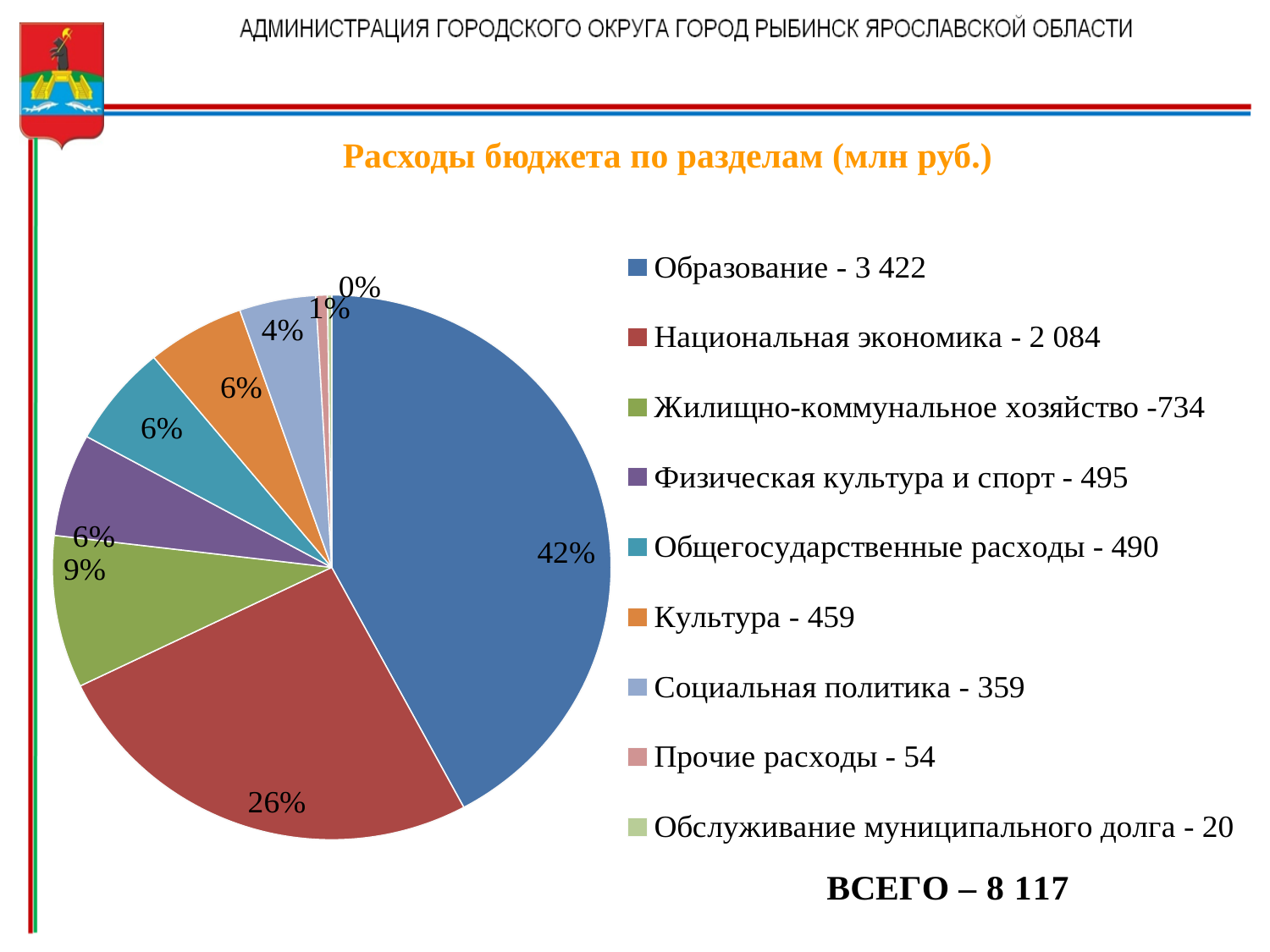
Which category has the largest value? Образование What is the total (ВСЕГО) shown on the slide? 8 117 What is the title of the chart? Расходы бюджета по разделам (млн руб.) What share of the pie does Образование take? 42% What is the value for Социальная политика according to the legend? 359 Which is larger: the value for Физическая культура и спорт or for Общегосударственные расходы? Физическая культура и спорт What is the value for Культура according to the legend? 459 What kind of chart is shown on the slide? pie chart What is the difference between the values for Образование and Национальная экономика? 1 338 Which category has the smallest value? Обслуживание муниципального долга What share of the pie does Национальная экономика take? 26% How many categories does the pie chart have? 9